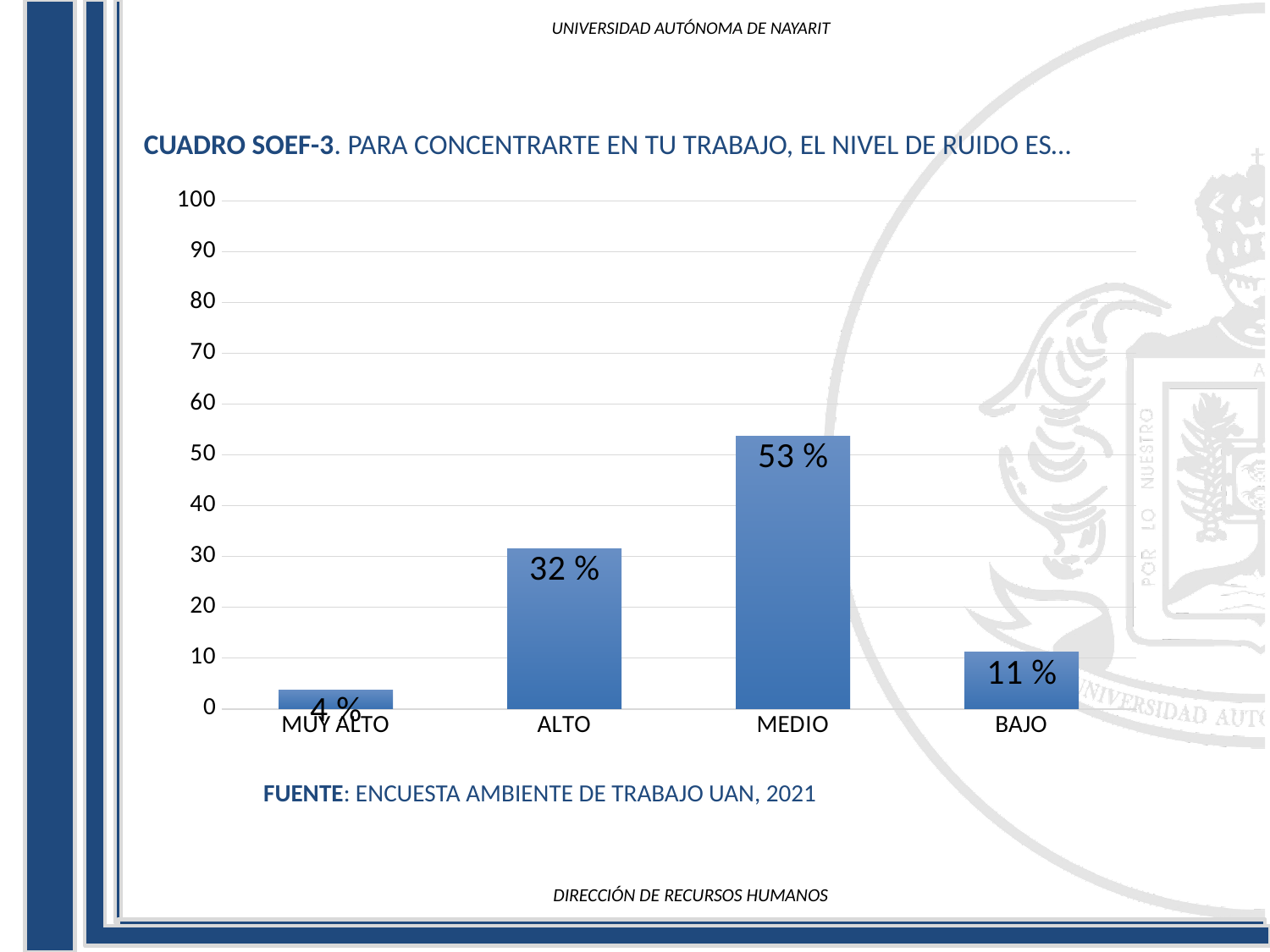
What is the value for ALTO? 32 % What is the difference between the values for MEDIO and ALTO? 21 % Which is larger, the value for ALTO or the value for BAJO? ALTO Which category has the highest value? MEDIO What is the value for MEDIO? 53 % Is the value for MEDIO greater or less than 50? greater What kind of chart is shown on the slide? bar chart What is the value for BAJO? 11 % What is the value for MUY ALTO? 4 % What is the difference between the values for BAJO and MUY ALTO? 7 % Which category has the lowest value? MUY ALTO How many categories are shown on the x axis? 4